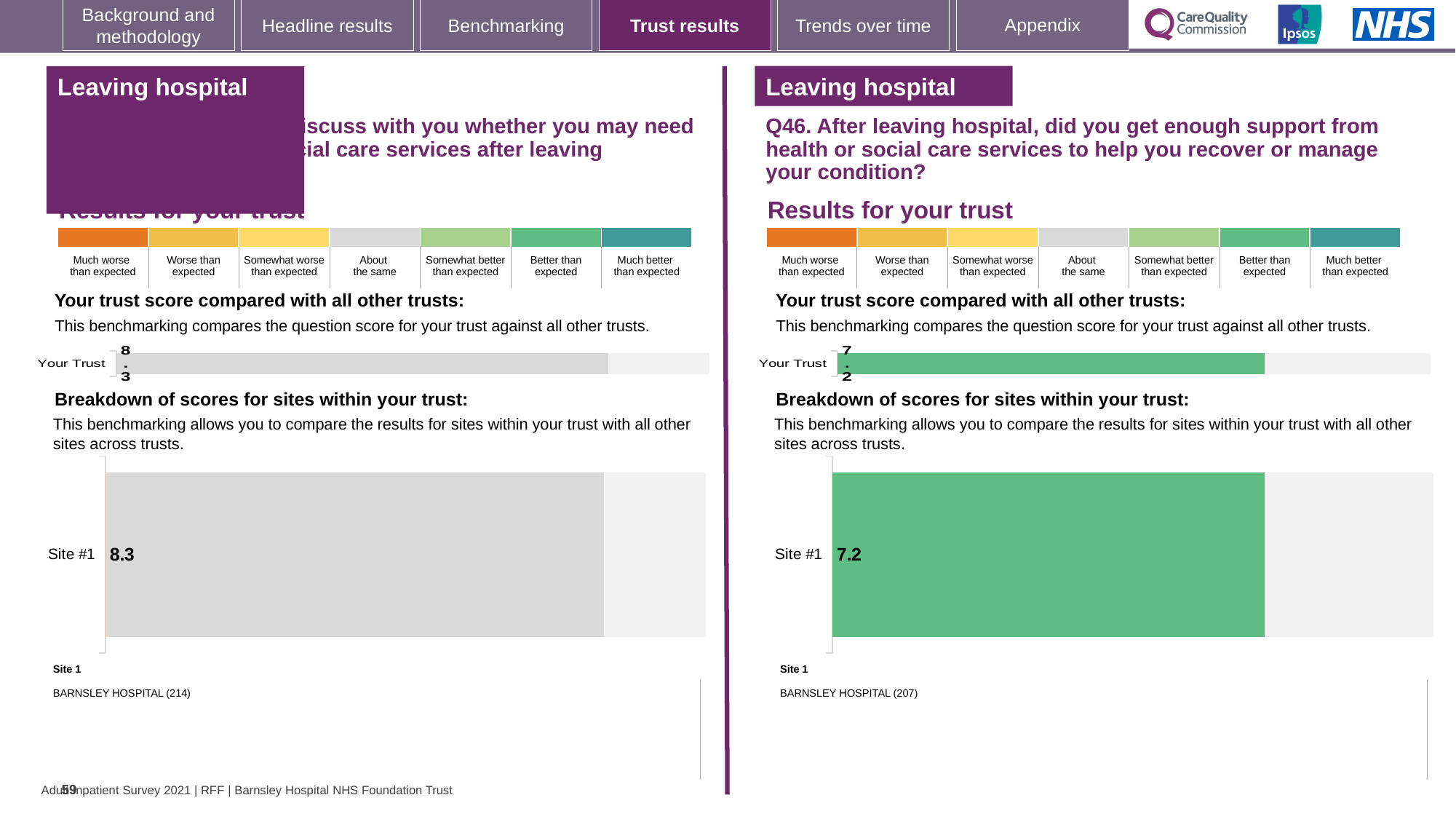
On the right-hand side of the slide (Q46), which site name is listed for Site 1? BARNSLEY HOSPITAL (207) How many sites are shown in the breakdown of scores chart on the left-hand side of the slide? 1 On the left-hand side of the slide, which site name is listed for Site 1? BARNSLEY HOSPITAL (214) On the left-hand side of the slide, what is the score shown for Your Trust? 8.3 What is the difference between the Your Trust score on the left-hand side of the slide and the Your Trust score on the right-hand side (Q46)? 1.1 On the right-hand side of the slide (Q46), what is the score shown for Site #1? 7.2 On the right-hand side of the slide (Q46), is the Your Trust score greater or less than the Site #1 score, or are they equal? Equal What type of chart is used to show the Site #1 score on the right-hand side of the slide (Q46)? Bar chart How many sites are shown in the breakdown of scores chart on the right-hand side of the slide (Q46)? 1 On the right-hand side of the slide (Q46), what is the score shown for Your Trust? 7.2 On the left-hand side of the slide, what is the score shown for Site #1? 8.3 Which is larger: the Site #1 score on the left-hand side of the slide or the Site #1 score on the right-hand side (Q46)? Left-hand side (8.3)